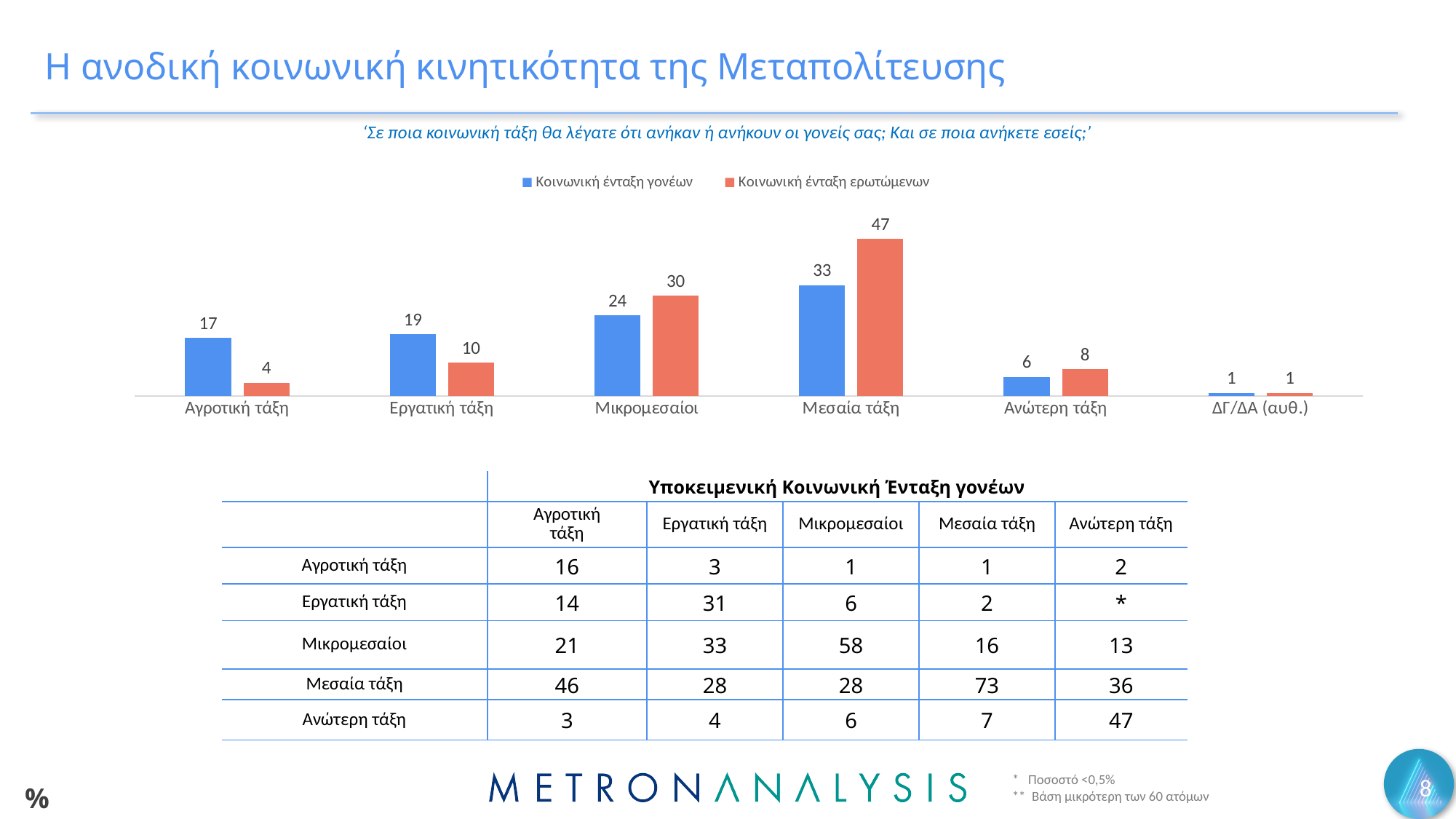
Which category has the highest value for Κοινωνική ένταξη ερωτώμενων? Μεσαία τάξη In the Μικρομεσαίοι category, which series has the larger value: Κοινωνική ένταξη γονέων or Κοινωνική ένταξη ερωτώμενων? Κοινωνική ένταξη ερωτώμενων In the Εργατική τάξη category, which series has the larger value: Κοινωνική ένταξη γονέων or Κοινωνική ένταξη ερωτώμενων? Κοινωνική ένταξη γονέων What kind of chart is shown on the slide? Bar chart What is the difference between Κοινωνική ένταξη ερωτώμενων and Κοινωνική ένταξη γονέων in the Μεσαία τάξη category? 14 Which category has the lowest value for Κοινωνική ένταξη γονέων? ΔΓ/ΔΑ (αυθ.) What is the value for Κοινωνική ένταξη ερωτώμενων in the Αγροτική τάξη category? 4 What is the value for Κοινωνική ένταξη ερωτώμενων in the Μικρομεσαίοι category? 30 What is the value for Κοινωνική ένταξη γονέων in the Μεσαία τάξη category? 33 How many categories are shown on the x axis of the chart? 6 How many series does the chart legend list? 2 What is the difference between Κοινωνική ένταξη γονέων and Κοινωνική ένταξη ερωτώμενων in the Αγροτική τάξη category? 13